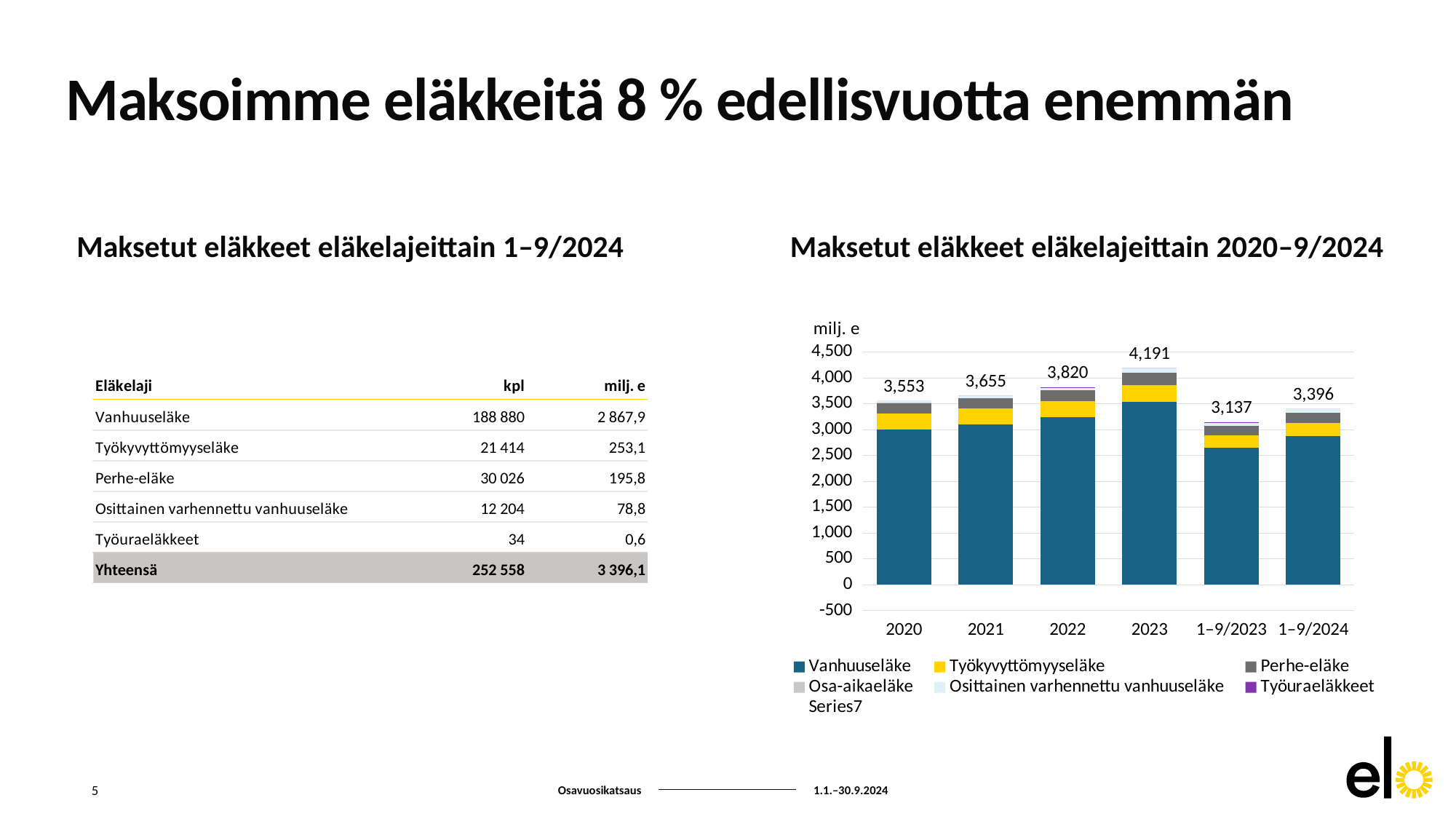
Which period has the lowest total in the chart 'Maksetut eläkkeet eläkelajeittain 2020–9/2024'? 1–9/2023 In the chart 'Maksetut eläkkeet eläkelajeittain 2020–9/2024', what is the difference between the totals for 2023 and 2022? 371 What kind of chart is 'Maksetut eläkkeet eläkelajeittain 2020–9/2024'? Stacked bar chart In the chart 'Maksetut eläkkeet eläkelajeittain 2020–9/2024', which total is larger, 2021 or 2022? 2022 What is the total value shown for 1–9/2024 in the chart 'Maksetut eläkkeet eläkelajeittain 2020–9/2024'? 3,396 In the chart 'Maksetut eläkkeet eläkelajeittain 2020–9/2024', what is the difference between the totals for 1–9/2024 and 1–9/2023? 259 What is the total value shown for 2020 in the chart 'Maksetut eläkkeet eläkelajeittain 2020–9/2024'? 3,553 How many series does the legend of the chart 'Maksetut eläkkeet eläkelajeittain 2020–9/2024' list? 7 In the chart 'Maksetut eläkkeet eläkelajeittain 2020–9/2024', is the Vanhuuseläke segment for 1–9/2023 greater or less than 2,500? greater What is the total value shown for 2023 in the chart 'Maksetut eläkkeet eläkelajeittain 2020–9/2024'? 4,191 How many periods are shown on the x axis of the chart 'Maksetut eläkkeet eläkelajeittain 2020–9/2024'? 6 Which period has the highest total in the chart 'Maksetut eläkkeet eläkelajeittain 2020–9/2024'? 2023